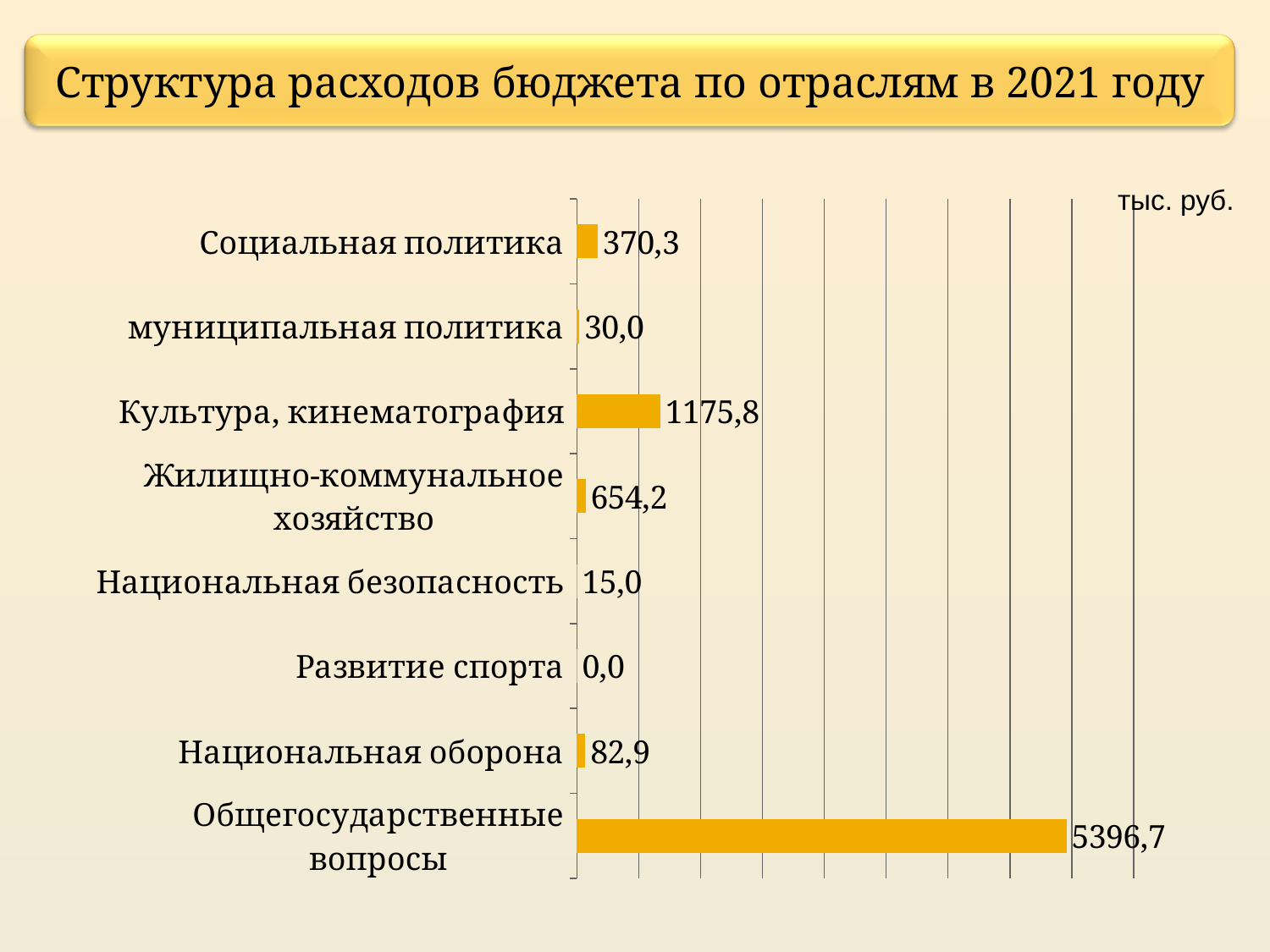
Which category has the lowest value? Развитие спорта What is the value for Национальная оборона? 82,9 What is the difference between Национальная оборона and Национальная безопасность? 67,9 What is the difference between Общегосударственные вопросы and Культура, кинематография? 4220,9 What is the value for Социальная политика? 370,3 Which is larger, Социальная политика or муниципальная политика? Социальная политика What unit is indicated for the values in the chart? тыс. руб. Which category has the highest value? Общегосударственные вопросы What kind of chart is shown on the slide? Bar chart What is the value for Культура, кинематография? 1175,8 How many categories are shown in the chart? 8 What is the value for Общегосударственные вопросы? 5396,7